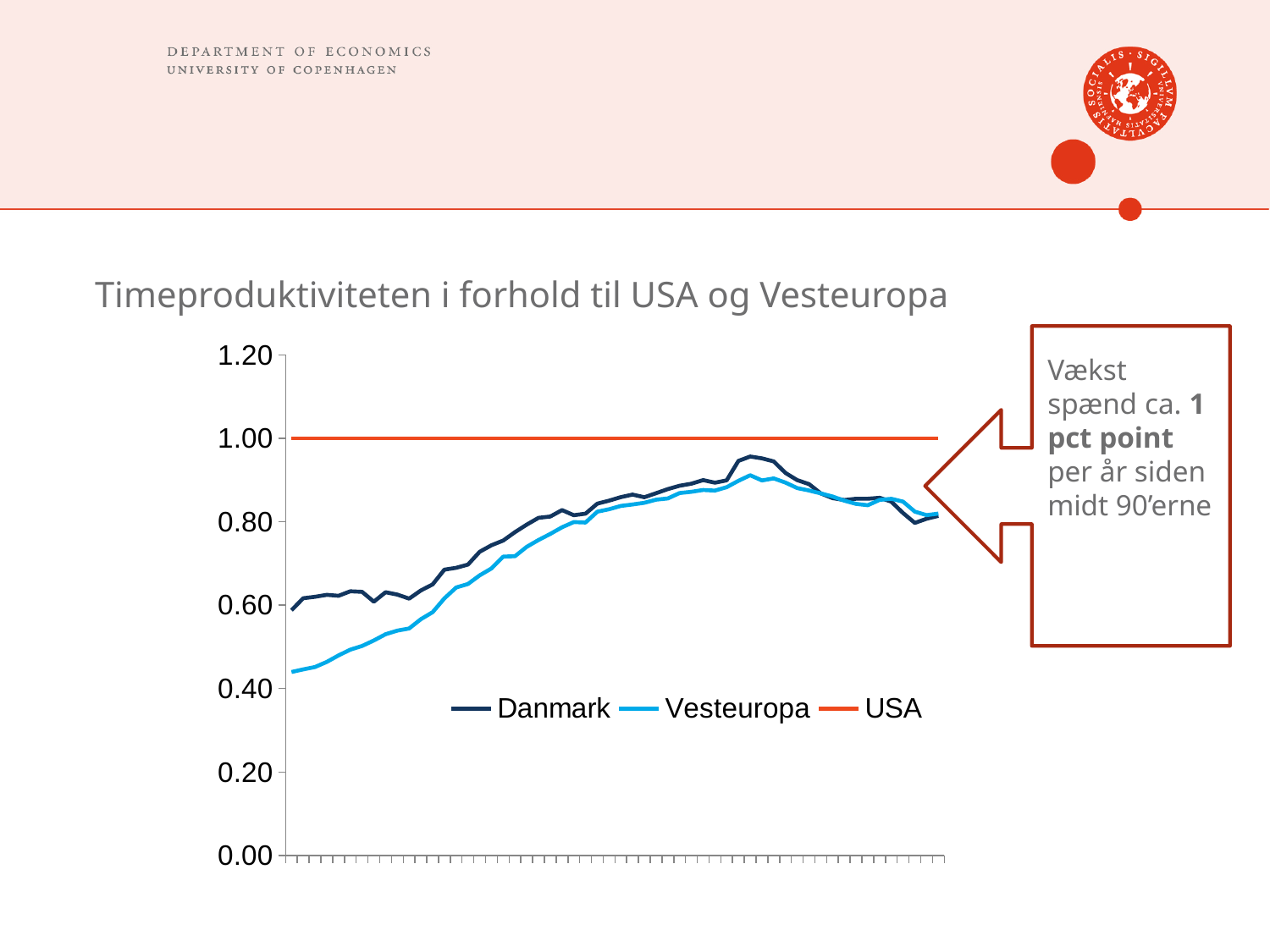
Is the peak value of the Danmark line greater or less than 1.00? less At the left end of the chart, which is larger, Danmark or Vesteuropa? Danmark What constant value does the USA line sit at? 1.00 Does the Vesteuropa line overall rise or fall from left to right? rise Which series has the highest value across the whole chart? USA What kind of chart is shown on the slide? Line chart Is the value for Vesteuropa at the left end of the chart greater or less than 0.60? less Is the value for Danmark at the left end of the chart greater or less than 0.40? greater Which series has the lowest value at the left end of the chart? Vesteuropa What is the title of the chart on the slide? Timeproduktiviteten i forhold til USA og Vesteuropa How many series does the chart legend list? 3 Which series are listed in the chart legend? Danmark, Vesteuropa, USA